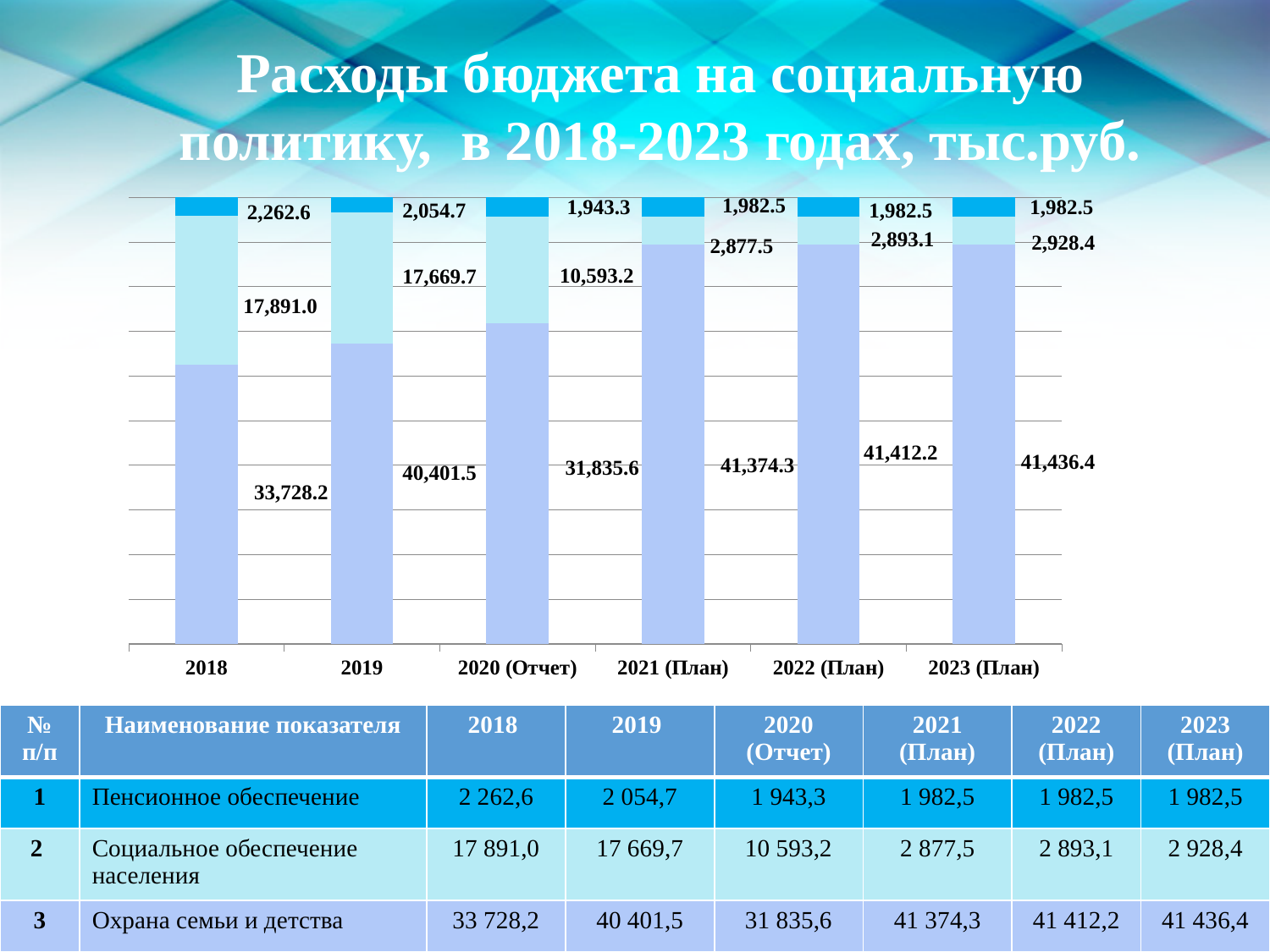
What is the total of the stacked bar for 2019? 60,125.9 Does the top segment (Пенсионное обеспечение) rise or fall from 2018 to 2020 (Отчет)? fall What is the value of the middle segment (Социальное обеспечение населения) for 2020 (Отчет)? 10,593.2 What kind of chart is shown on the slide? stacked bar chart How many year categories are shown on the x axis of the chart? 6 What is the value of the bottom segment (Охрана семьи и детства) of the 2018 bar? 33,728.2 What is the difference between the bottom segment values for 2019 and 2018? 6,673.3 In which year is the middle segment (Социальное обеспечение населения) the largest? 2018 What is the value of the top segment (Пенсионное обеспечение) for 2023 (План)? 1,982.5 What is the total of the stacked bar for 2018? 53,881.8 Which is larger: the bottom segment for 2020 (Отчет) or for 2021 (План)? 2021 (План) In which year is the middle segment (Социальное обеспечение населения) the smallest? 2021 (План)